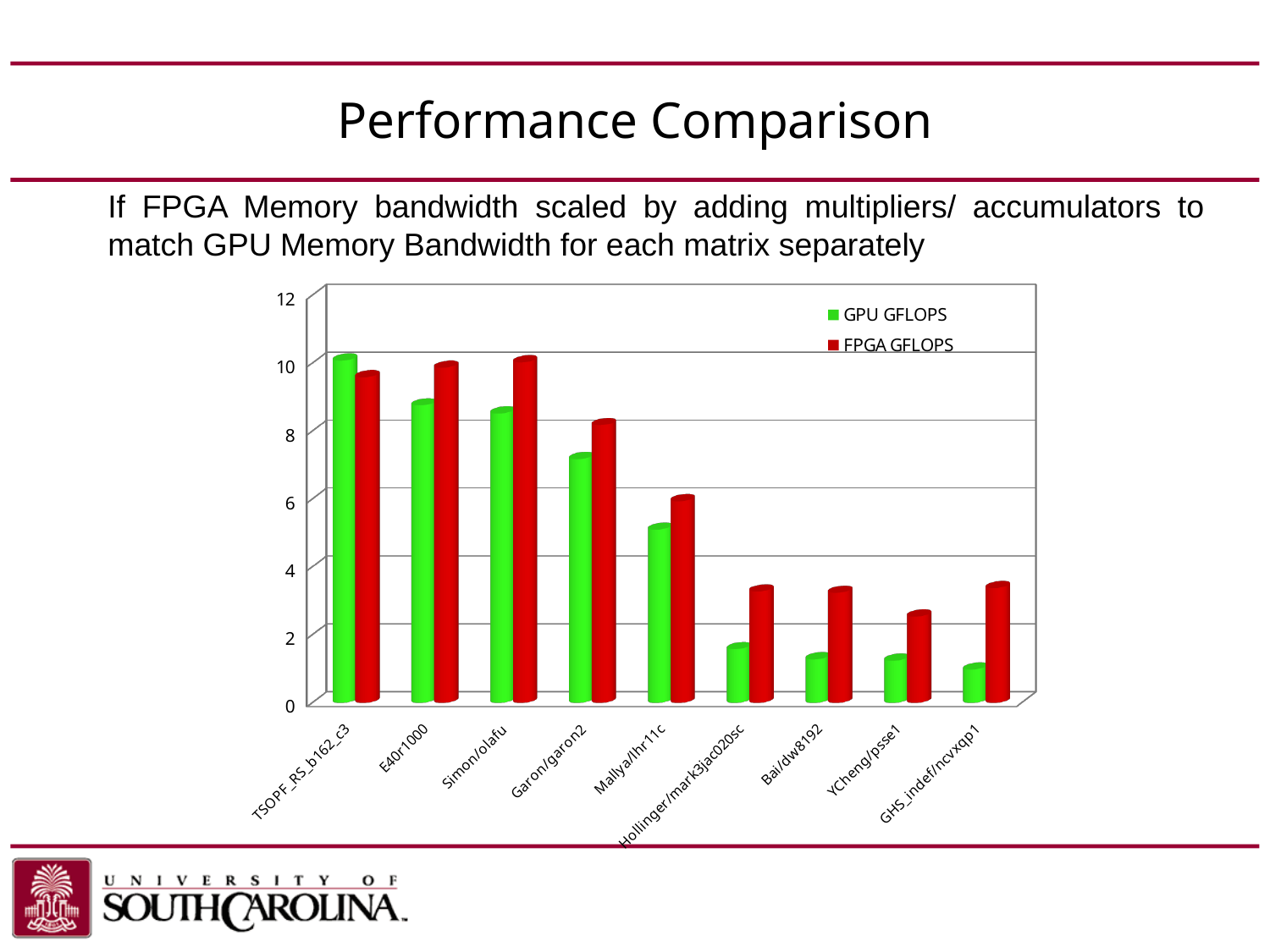
Is the FPGA GFLOPS value for Bai/dw8192 greater or less than 4? less How many series does the chart legend list? 2 Is the FPGA GFLOPS value for Mallya/lhr11c greater or less than 4? greater Which matrix has the highest GPU GFLOPS value? TSOPF_RS_b162_c3 For GHS_indef/ncvxqp1, which is larger: GPU GFLOPS or FPGA GFLOPS? FPGA GFLOPS Is the GPU GFLOPS value for Hollinger/mark3jac020sc greater or less than 2? less Which matrix has the lowest GPU GFLOPS value? GHS_indef/ncvxqp1 What kind of chart is shown on the slide? bar chart How many matrices (categories) are shown on the x axis of the chart? 9 Which series is shown in red in the chart? FPGA GFLOPS Do the GPU GFLOPS values generally rise or fall from left to right along the x axis? fall